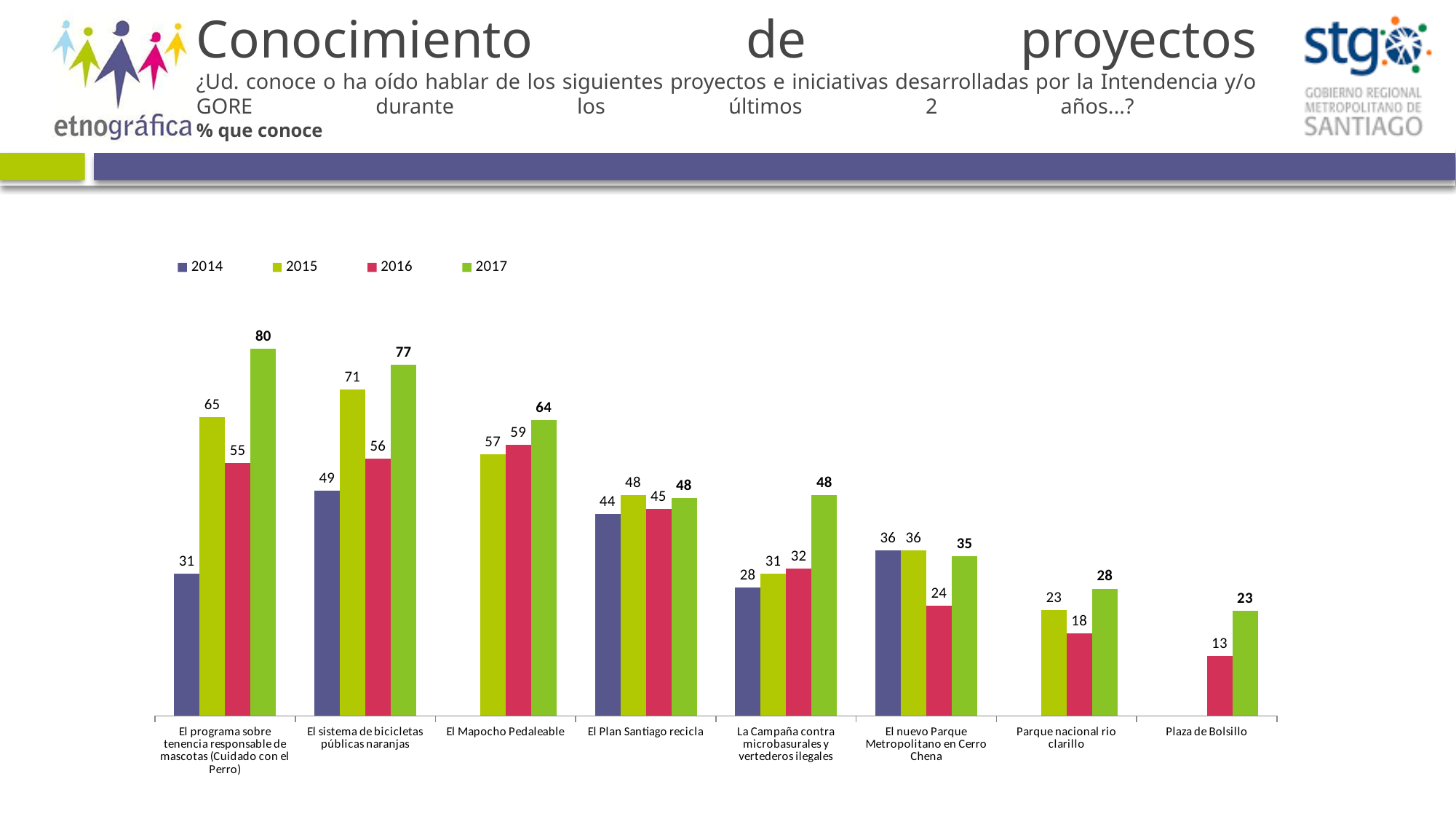
What kind of chart is shown on the slide? Bar chart What is the 2017 value for El Mapocho Pedaleable? 64 What is the 2016 value for Plaza de Bolsillo? 13 Which colour represents the 2017 series in the legend? Green Which project has the highest 2017 value? El programa sobre tenencia responsable de mascotas (Cuidado con el Perro) Which project has the lowest 2016 value? Plaza de Bolsillo How many projects are shown on the x axis? 8 How many series does the legend list? 4 What is the 2014 value for El sistema de bicicletas públicas naranjas? 49 Which is larger for El nuevo Parque Metropolitano en Cerro Chena: the 2016 value or the 2017 value? 2017 For La Campaña contra microbasurales y vertederos ilegales, do the values rise or fall from 2014 to 2017? Rise What is the difference between the 2017 and 2014 values for El programa sobre tenencia responsable de mascotas (Cuidado con el Perro)? 49